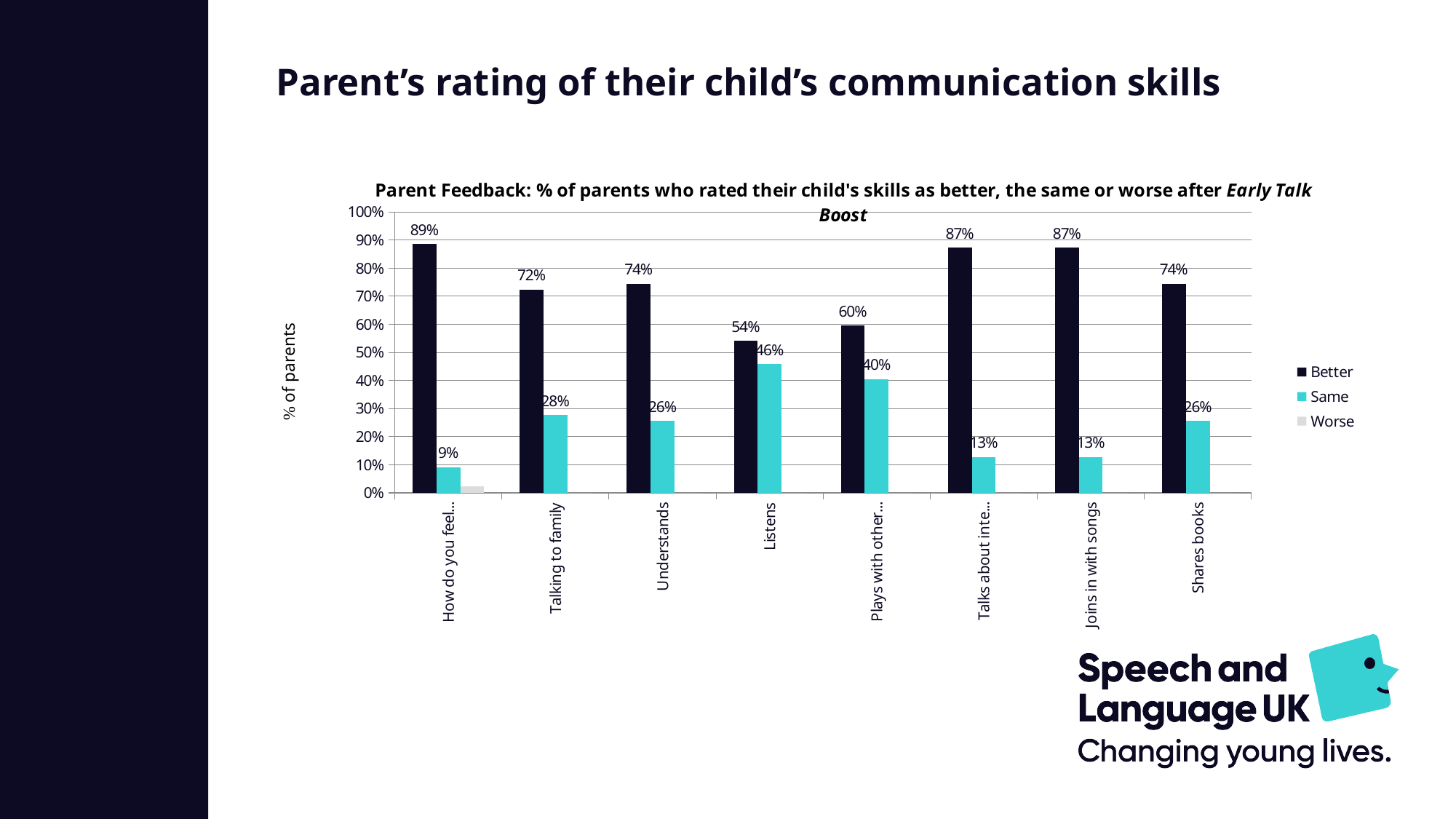
Which has the larger Better value: Joins in with songs or Shares books? Joins in with songs What kind of chart is shown on the slide? Bar chart What is the Same value for Listens? 46% Is the Worse value for the first category greater or less than 10%? less For Understands, how much higher is the Better value than the Same value? 48 percentage points How many series does the legend list? 3 How many categories are shown on the x axis? 8 What percentage of parents rated their child's skills as Better for Talking to family? 72% What is the Better value for Shares books? 74% Which category has the lowest Better value? Listens What is the Same value for Joins in with songs? 13% Which category has the highest Same value? Listens